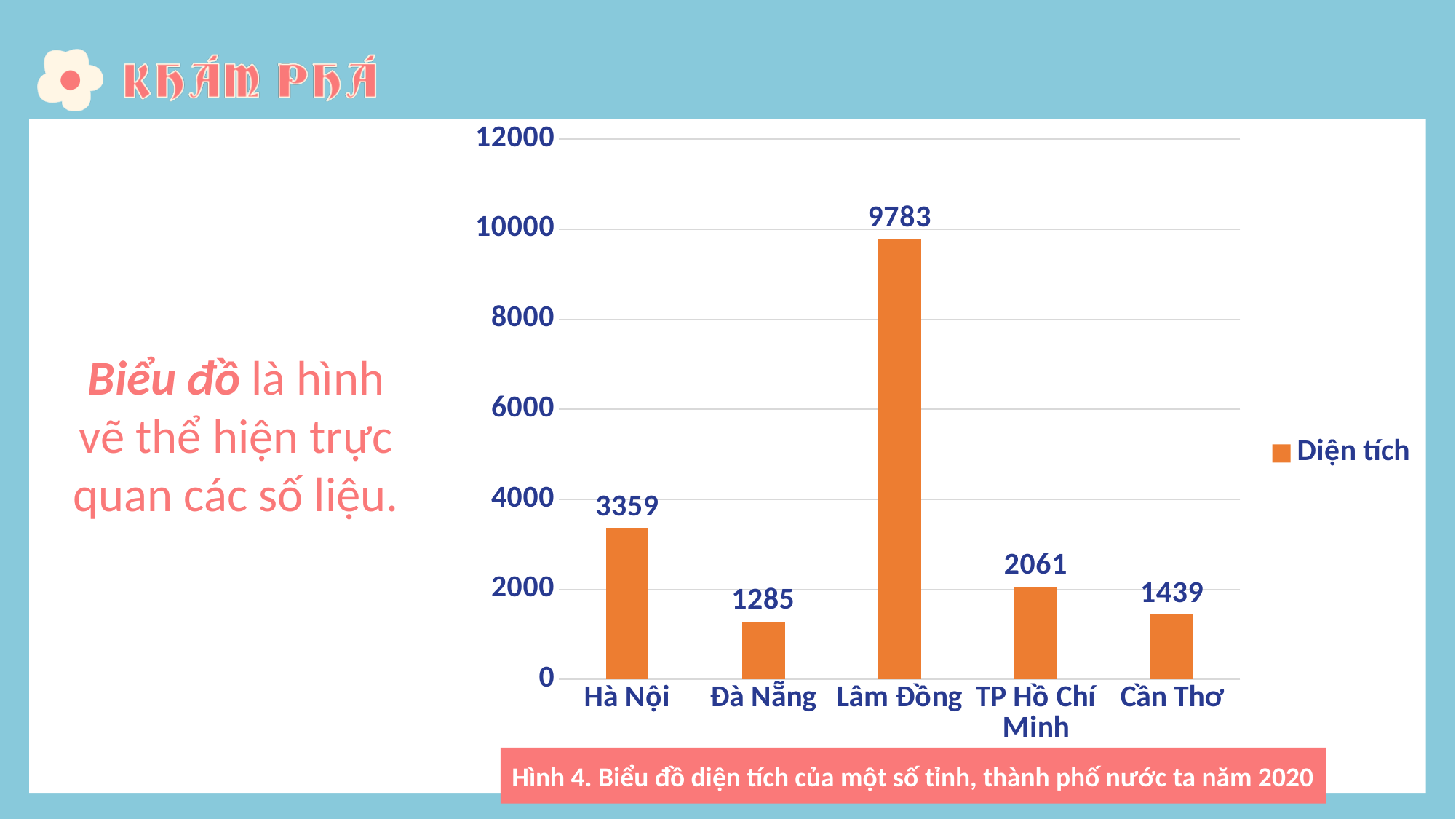
What is the value for Cần Thơ? 1439 What is the name of the series shown in the legend? Diện tích What kind of chart is shown? bar chart Which category has the lowest value? Đà Nẵng How many series does the legend list? 1 Which category has the highest value? Lâm Đồng How many categories are shown on the x axis? 5 Which is larger, the value for Đà Nẵng or the value for Cần Thơ? Cần Thơ What is the difference between the values for Hà Nội and TP Hồ Chí Minh? 1298 What is the value for Lâm Đồng? 9783 Is the value for TP Hồ Chí Minh greater or less than 4000? less What is the value for Hà Nội? 3359